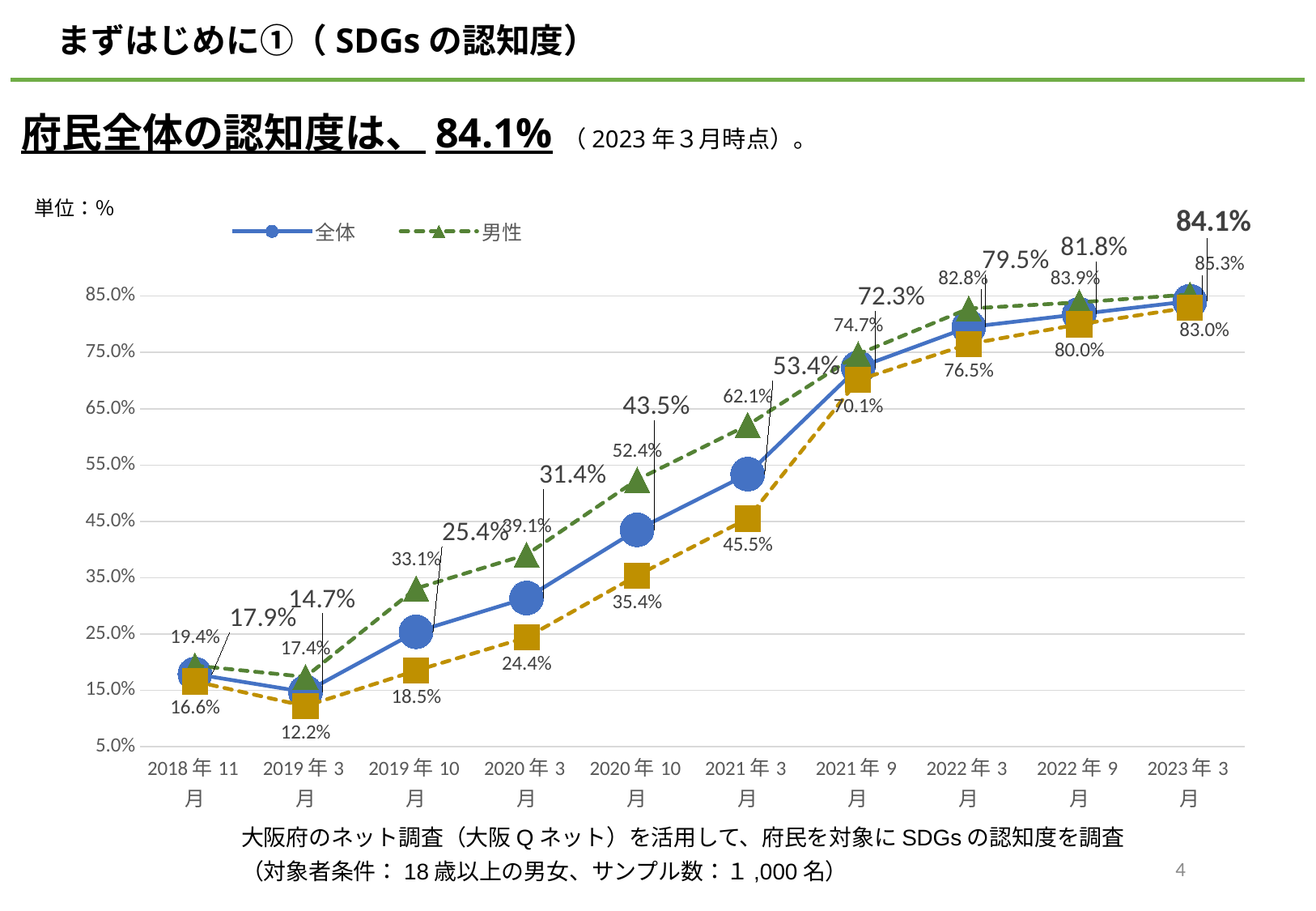
By how much did the 全体 value increase from 2021年3月 to 2021年9月? 18.9 percentage points What is the value of 全体 at 2019年10月? 25.4% Does the 全体 value rise or fall from 2019年3月 to 2023年3月? Rises What is the difference between the 男性 and 全体 values at 2023年3月? 1.2 percentage points How many time points are shown on the x axis? 10 What kind of chart is shown on the slide? Line chart What is the value of 全体 at 2023年3月? 84.1% At 2021年9月, which is larger: the 全体 value or the 男性 value? 男性 At which time point is the 男性 value highest? 2023年3月 What is the value of 男性 at 2021年3月? 62.1% What is the value of 男性 at 2018年11月? 19.4% At which time point is the 全体 value lowest? 2019年3月